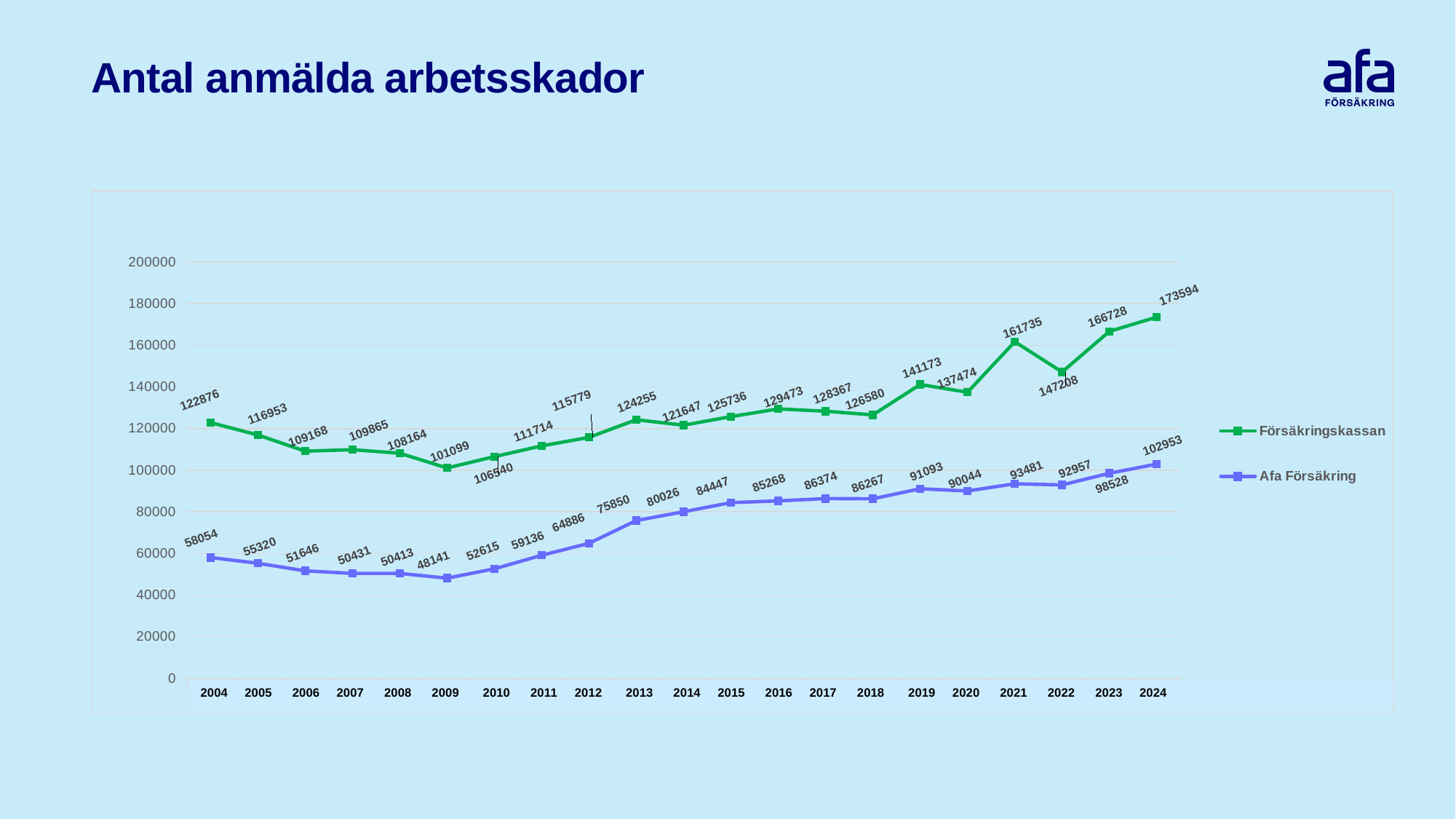
What is the difference between the Försäkringskassan and Afa Försäkring values in 2024? 70641 What is the value for Afa Försäkring in 2009? 48141 Does the Afa Försäkring series generally rise or fall from 2009 to 2024? Rise What is the value for Försäkringskassan in 2021? 161735 In which year is the Afa Försäkring series at its highest? 2024 What kind of chart is shown on the slide? Line chart How many series does the legend list? 2 Which is larger, the Försäkringskassan value in 2021 or in 2022? 2021 What is the value for Försäkringskassan in 2024? 173594 By how much did the Försäkringskassan value change from 2023 to 2024? 6866 How many years are shown on the x axis? 21 In which year is the Försäkringskassan series at its lowest? 2009